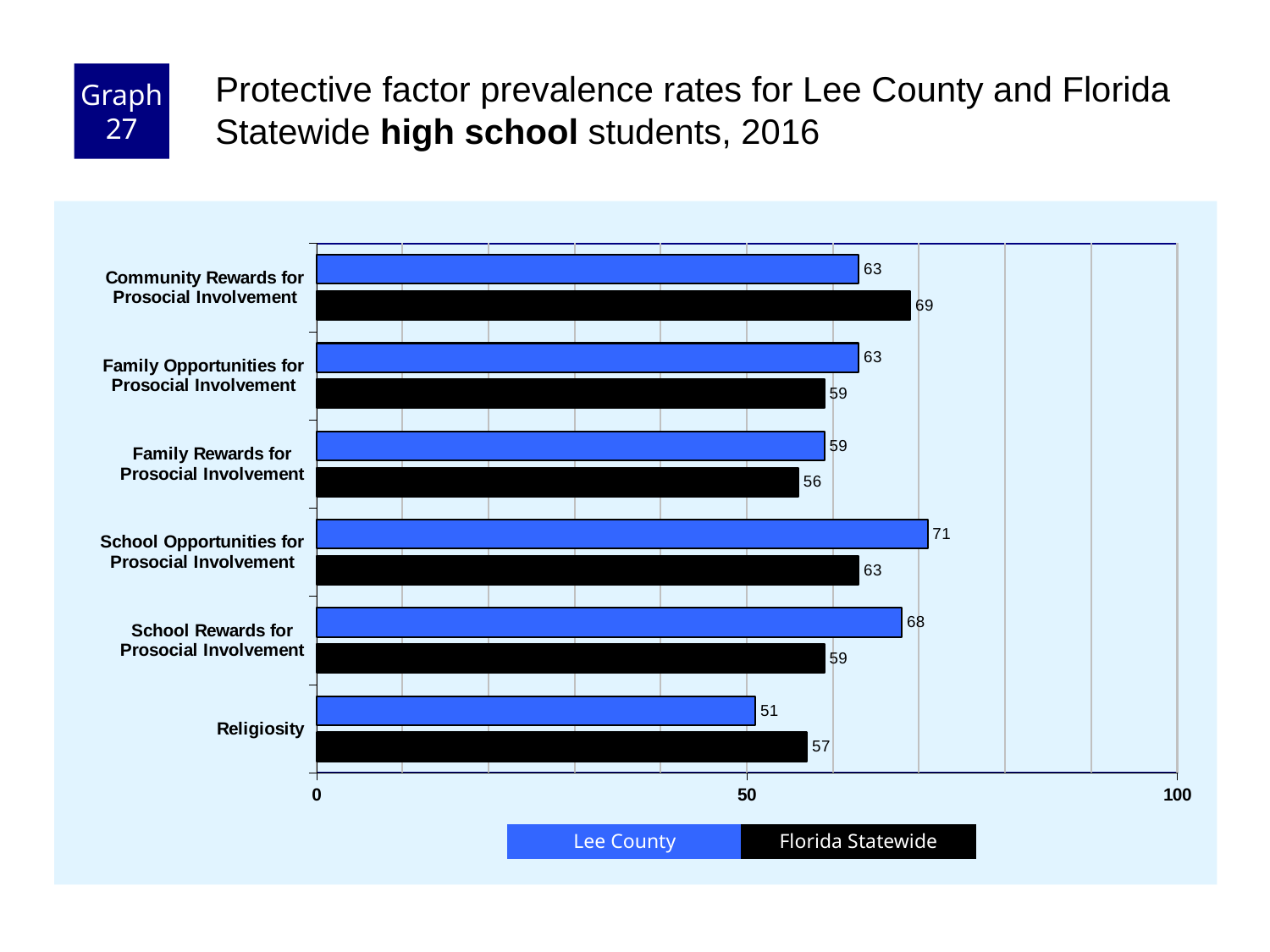
Which is larger for Religiosity, the Lee County value or the Florida Statewide value? Florida Statewide Which category has the lowest Florida Statewide value? Family Rewards for Prosocial Involvement How many series does the legend list? 2 What is the difference between the Lee County and Florida Statewide values for School Rewards for Prosocial Involvement? 9 Is the Lee County value for Religiosity greater or less than 50? greater How many categories are shown on the chart? 6 Which category has the highest Lee County value? School Opportunities for Prosocial Involvement Which category has the lowest Lee County value? Religiosity What is the Florida Statewide value for Religiosity? 57 What is the Florida Statewide value for Community Rewards for Prosocial Involvement? 69 What kind of chart is shown on the slide? bar chart What is the Lee County value for School Opportunities for Prosocial Involvement? 71